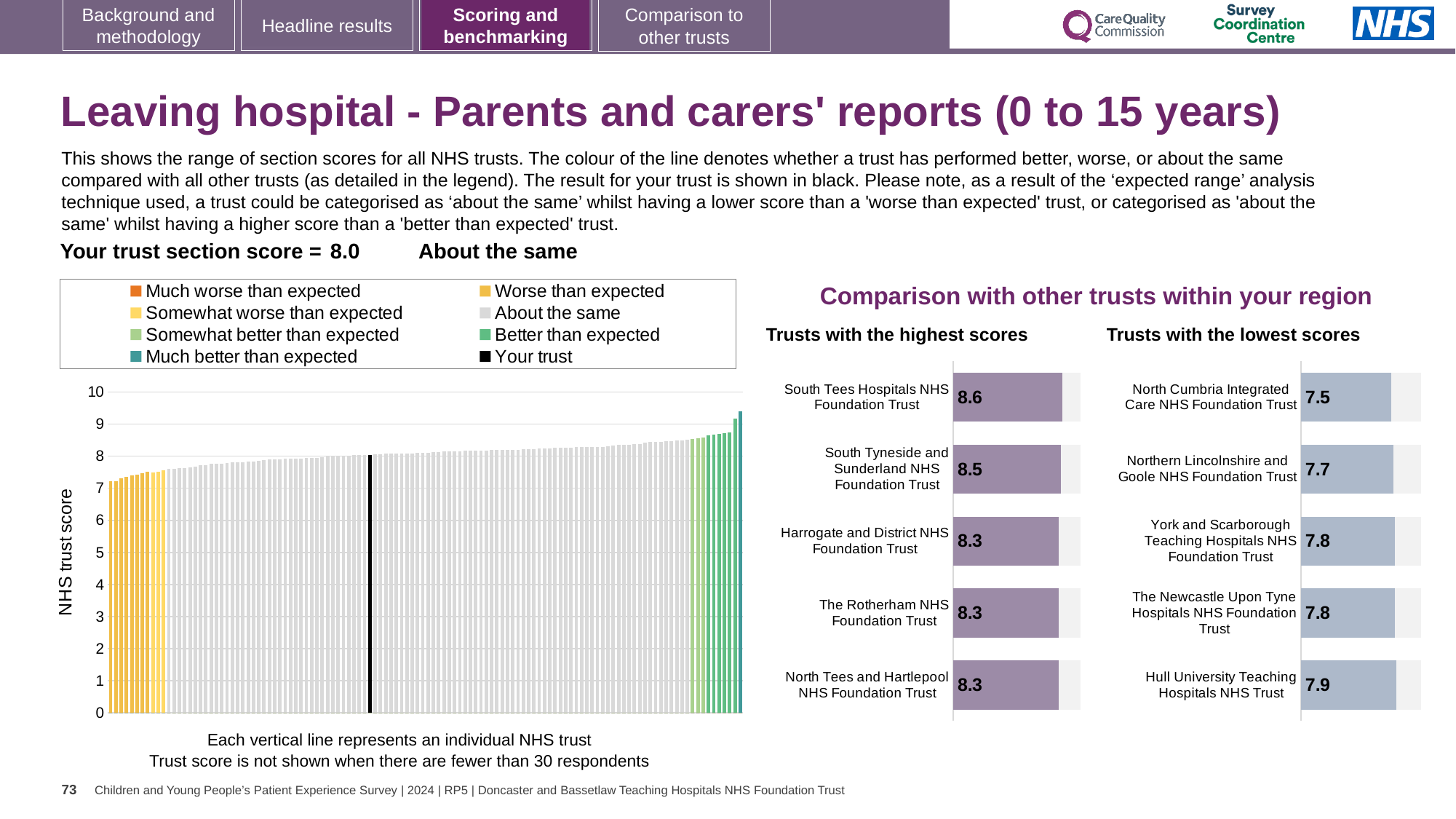
In the 'Trusts with the lowest scores' chart, what is the score for North Cumbria Integrated Care NHS Foundation Trust? 7.5 In the 'Trusts with the lowest scores' chart, which trust has the lowest score? North Cumbria Integrated Care NHS Foundation Trust In the 'Trusts with the lowest scores' chart, what is the difference between the scores of Hull University Teaching Hospitals NHS Trust and North Cumbria Integrated Care NHS Foundation Trust? 0.4 In the 'Trusts with the highest scores' chart, what is the difference between the scores of South Tees Hospitals NHS Foundation Trust and Harrogate and District NHS Foundation Trust? 0.3 How many entries does the legend of the main NHS trust score chart on the left list? 8 In the main NHS trust score chart on the left, do the values rise or fall from left to right? rise In the 'Trusts with the highest scores' chart, which trust has the highest score? South Tees Hospitals NHS Foundation Trust In the 'Trusts with the lowest scores' chart, which has the higher score: Northern Lincolnshire and Goole NHS Foundation Trust or Hull University Teaching Hospitals NHS Trust? Hull University Teaching Hospitals NHS Trust In the 'Trusts with the lowest scores' chart, what is the score for Hull University Teaching Hospitals NHS Trust? 7.9 In the 'Trusts with the highest scores' chart, what is the score for South Tyneside and Sunderland NHS Foundation Trust? 8.5 In the 'Trusts with the highest scores' chart, what is the score for South Tees Hospitals NHS Foundation Trust? 8.6 How many trusts are shown in the 'Trusts with the highest scores' chart? 5